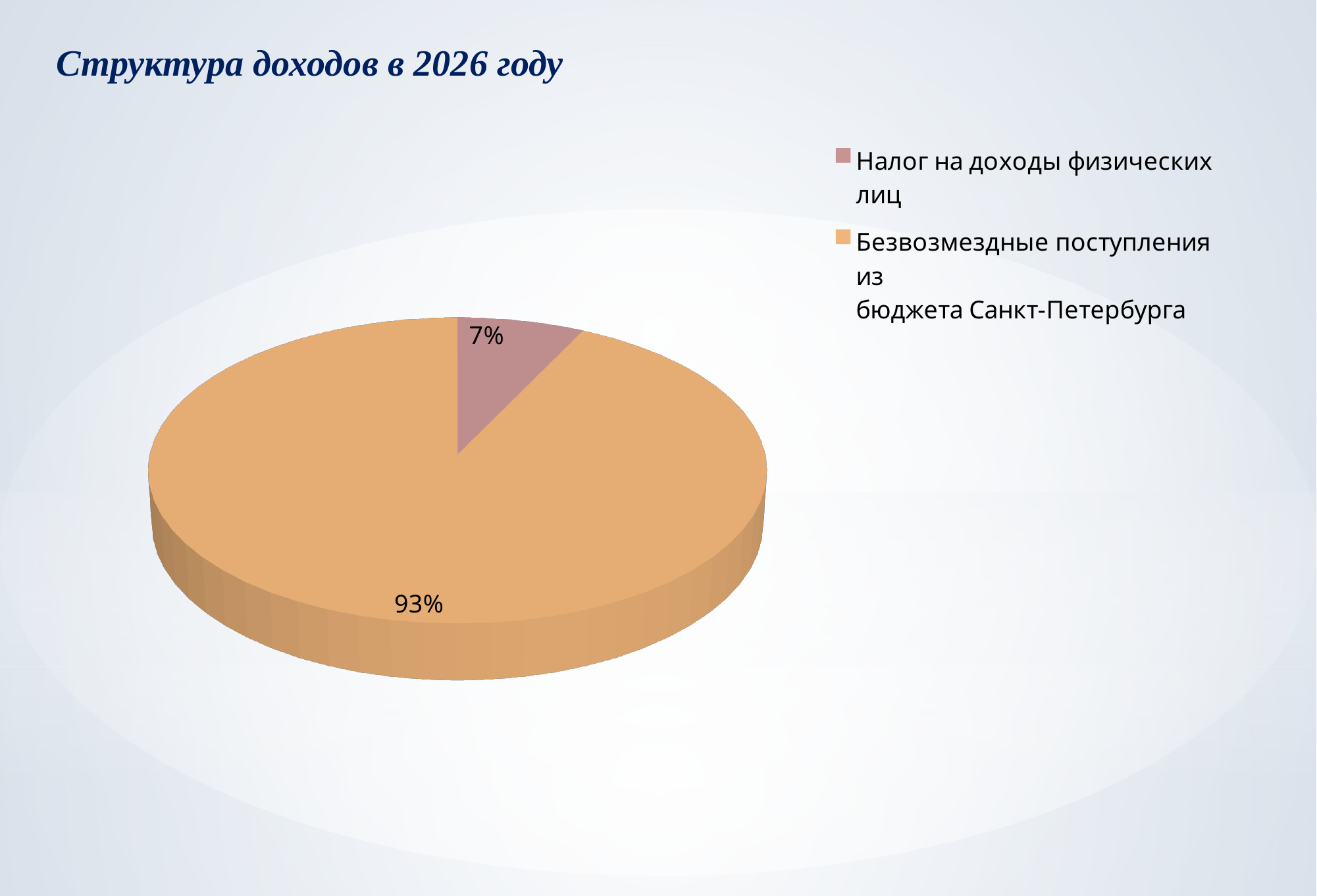
How many slices does the pie chart have? 2 Which is larger: the slice for "Налог на доходы физических лиц" or the slice for "Безвозмездные поступления из бюджета Санкт-Петербурга"? Безвозмездные поступления из бюджета Санкт-Петербурга What is the title of the slide? Структура доходов в 2026 году What kind of chart is shown on the slide? Pie chart What share of the pie does "Налог на доходы физических лиц" represent? 7% What colour is the slice for "Налог на доходы физических лиц"? Pink (mauve) Which category has the largest slice of the pie? Безвозмездные поступления из бюджета Санкт-Петербурга How many entries does the legend list? 2 What is the difference in percentage points between the two slices? 86 Which category has the smallest slice of the pie? Налог на доходы физических лиц What share of the pie does "Безвозмездные поступления из бюджета Санкт-Петербурга" represent? 93%